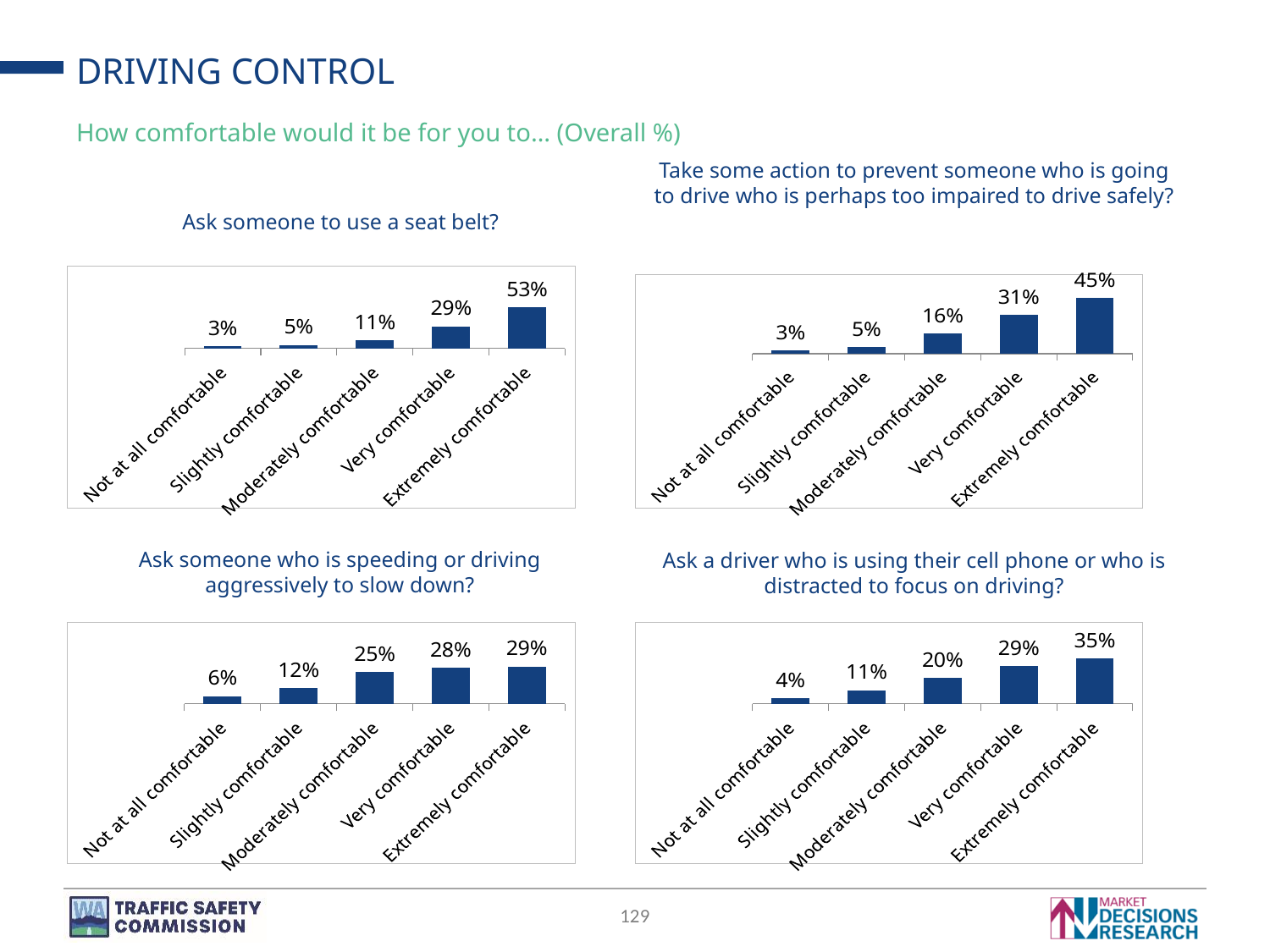
In the 'Ask a driver who is using their cell phone or who is distracted to focus on driving?' chart, what is the value for Moderately comfortable? 20% In the 'Ask someone to use a seat belt?' chart, what is the value for Extremely comfortable? 53% How many charts are shown on the slide? 4 In the 'Ask someone to use a seat belt?' chart, what is the difference between Extremely comfortable and Very comfortable? 24% In the 'Ask someone to use a seat belt?' chart, which category has the highest value? Extremely comfortable What type of chart is the 'Ask a driver who is using their cell phone or who is distracted to focus on driving?' chart? Bar chart In the 'Take some action to prevent someone who is going to drive who is perhaps too impaired to drive safely?' chart, which is larger: Moderately comfortable or Very comfortable? Very comfortable In the 'Ask someone who is speeding or driving aggressively to slow down?' chart, what is the value for Slightly comfortable? 12% In the 'Ask someone who is speeding or driving aggressively to slow down?' chart, do the values rise or fall from Not at all comfortable to Extremely comfortable? Rise In the 'Take some action to prevent someone who is going to drive who is perhaps too impaired to drive safely?' chart, what is the value for Very comfortable? 31% How many categories are shown in the 'Ask someone who is speeding or driving aggressively to slow down?' chart? 5 In the 'Ask a driver who is using their cell phone or who is distracted to focus on driving?' chart, which category has the lowest value? Not at all comfortable